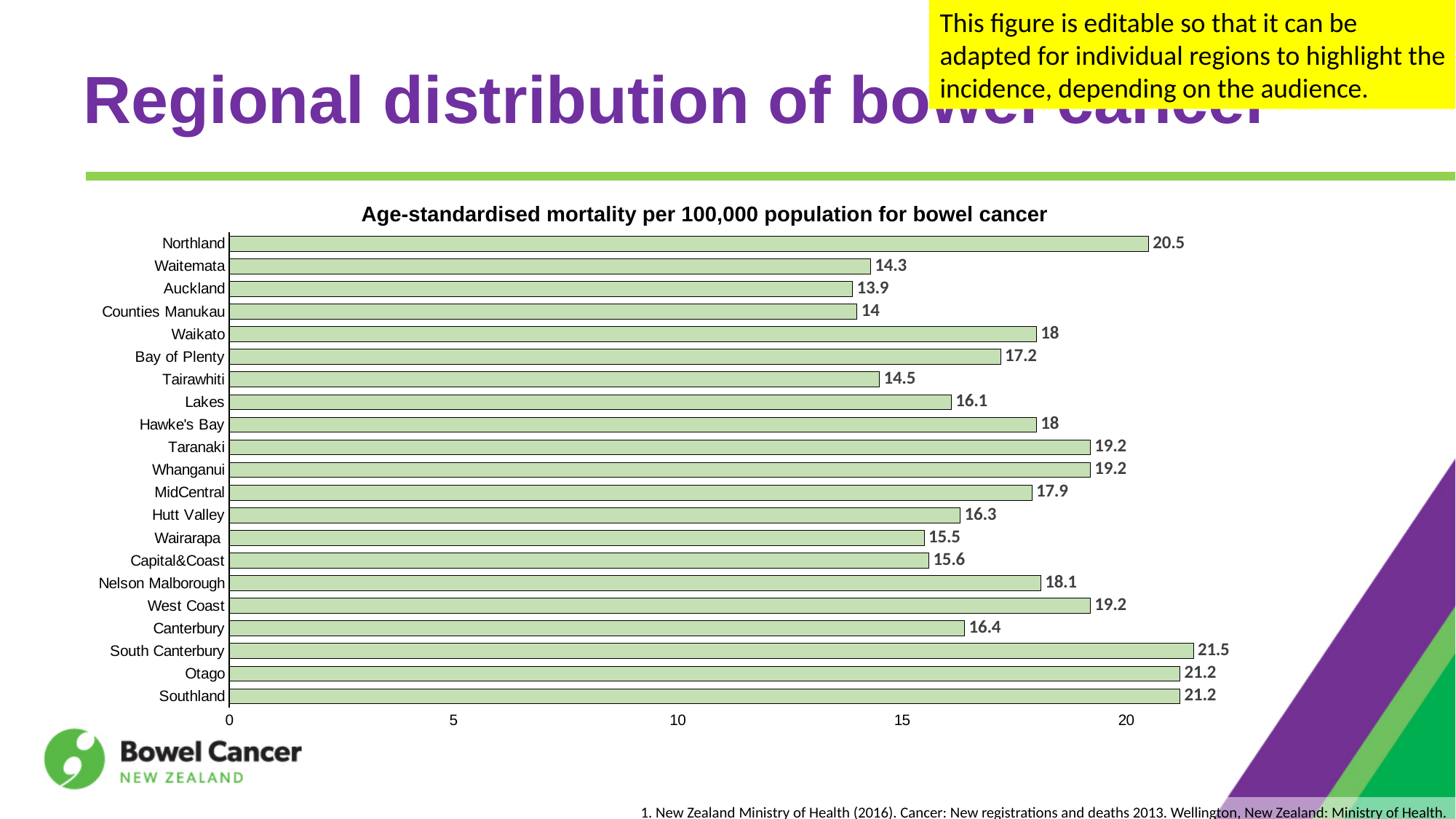
What is the difference between the values for South Canterbury and Auckland? 7.6 How many regions are shown in the chart? 21 What is the value shown for Nelson Malborough? 18.1 Which region has the lowest age-standardised mortality rate? Auckland What is the age-standardised mortality per 100,000 population for Northland? 20.5 What is the value shown for Tairawhiti? 14.5 Which has a higher mortality rate, Waikato or Bay of Plenty? Waikato Which has a higher mortality rate, Canterbury or Otago? Otago What is the title of the chart? Age-standardised mortality per 100,000 population for bowel cancer What type of chart is used on this slide? Bar chart Which region has the highest age-standardised mortality rate? South Canterbury What is the difference between the values for Northland and Waitemata? 6.2